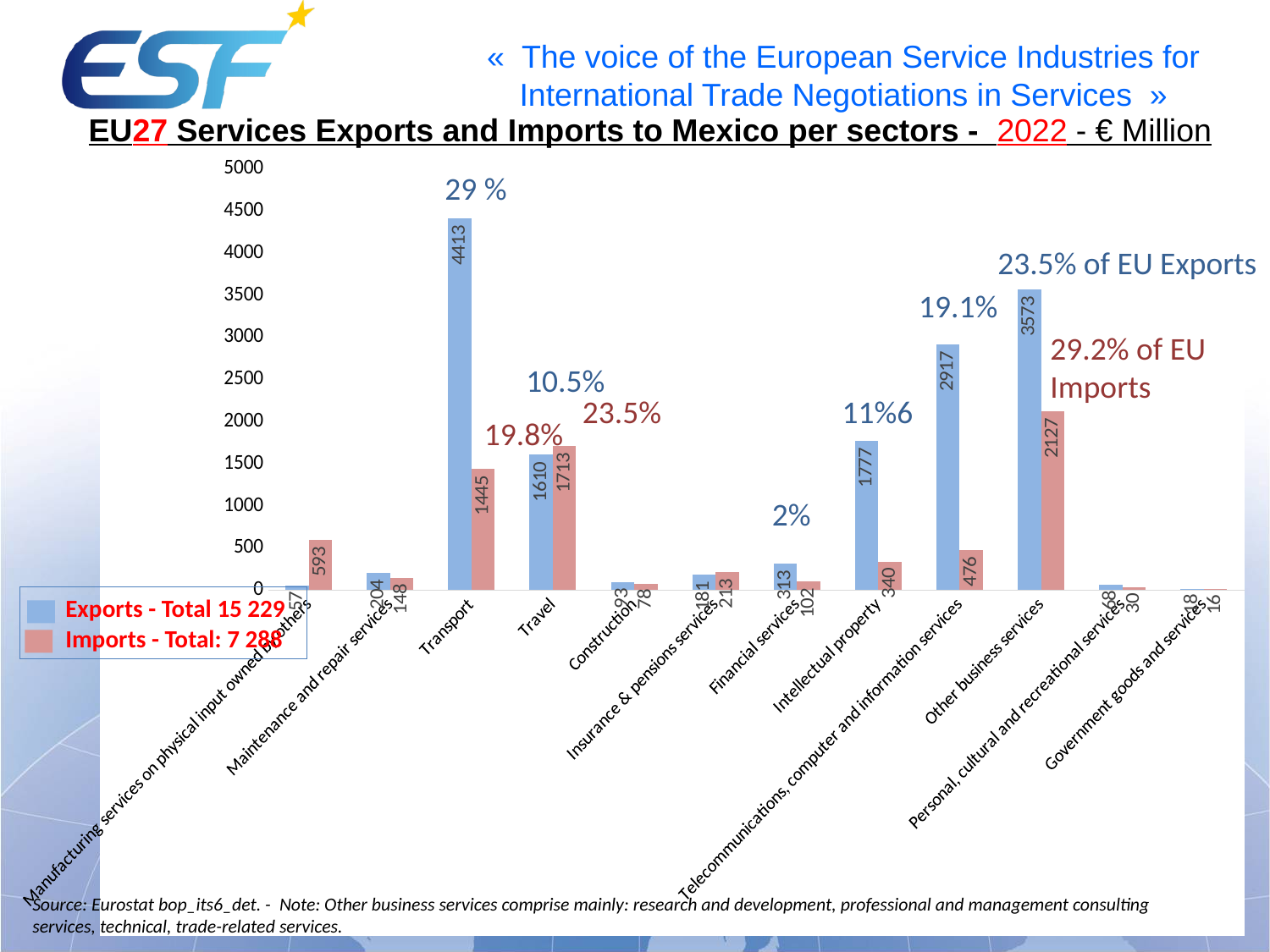
How many series does the legend list? 2 What total does the legend give for Exports? 15 229 Which sector has the lowest Imports value? Government goods and services How many sectors are shown on the x axis? 12 What is the value of Imports for Travel? 1713 What is the value of Exports for Transport? 4413 Is the Exports value for Intellectual property greater or less than 1500? greater What is the value of Imports for Other business services? 2127 Which sector has the highest Exports value? Transport What is the difference between Exports and Imports for Transport? 2968 For Travel, which is larger: Exports or Imports? Imports What is the value of Exports for Telecommunications, computer and information services? 2917